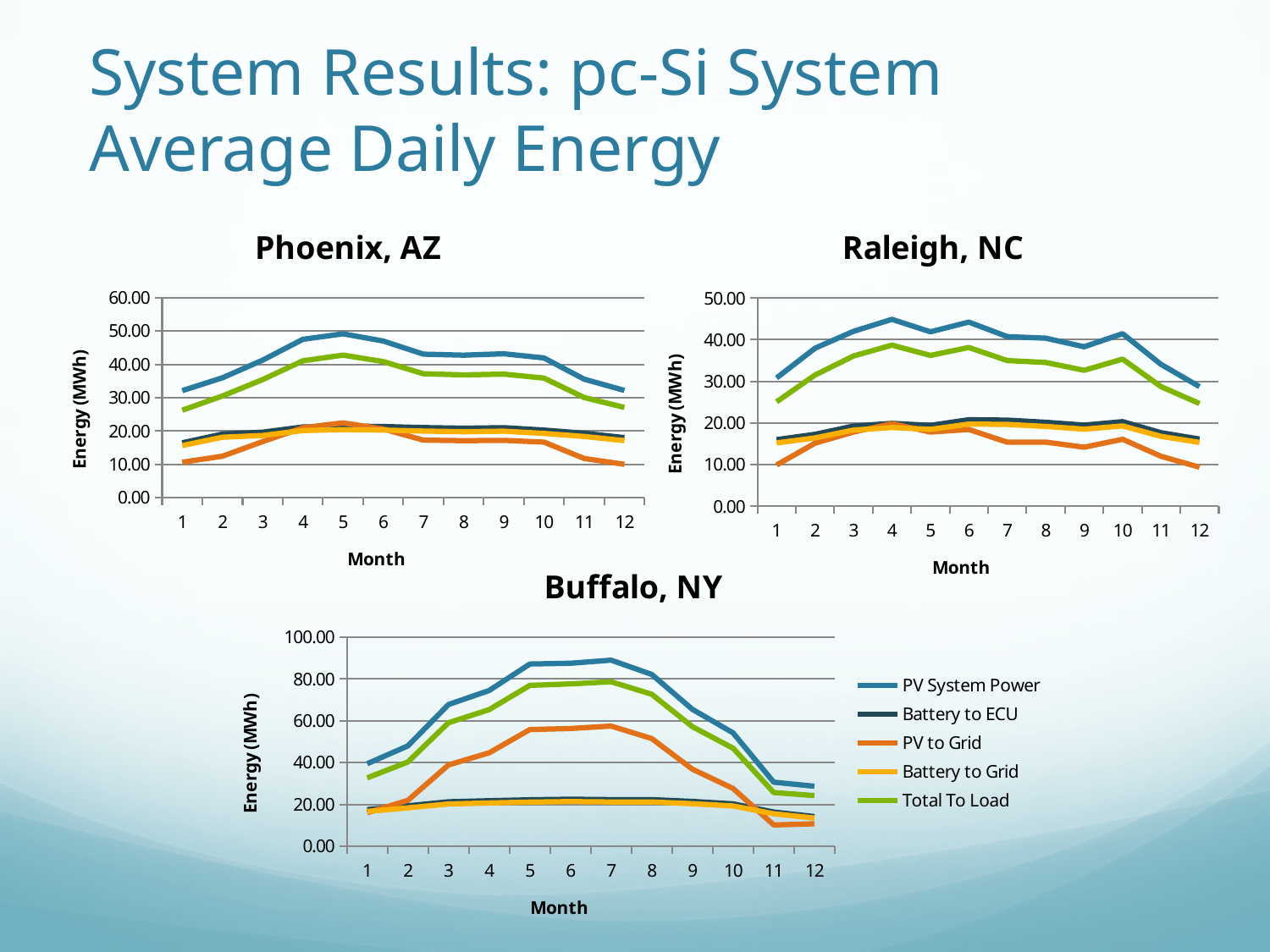
In the Buffalo, NY chart, which month has the lowest PV System Power value? 12 In the Buffalo, NY chart, is the PV System Power value for month 7 greater or less than 80.00? greater In the Buffalo, NY chart, is the PV to Grid value for month 11 greater or less than 20.00? less How many months are plotted along the x axis of the Buffalo, NY chart? 12 What kind of chart is the Phoenix, AZ chart? line chart Which series is drawn in orange in the charts? PV to Grid In the Phoenix, AZ chart, is the PV System Power value for month 5 greater or less than 40.00? greater In the Buffalo, NY chart, which series is higher at month 7: PV System Power or Total To Load? PV System Power In the Buffalo, NY chart, does the PV System Power line rise or fall from month 7 to month 12? fall In the Phoenix, AZ chart, which month has the highest PV System Power value? 5 How many series does the legend list? 5